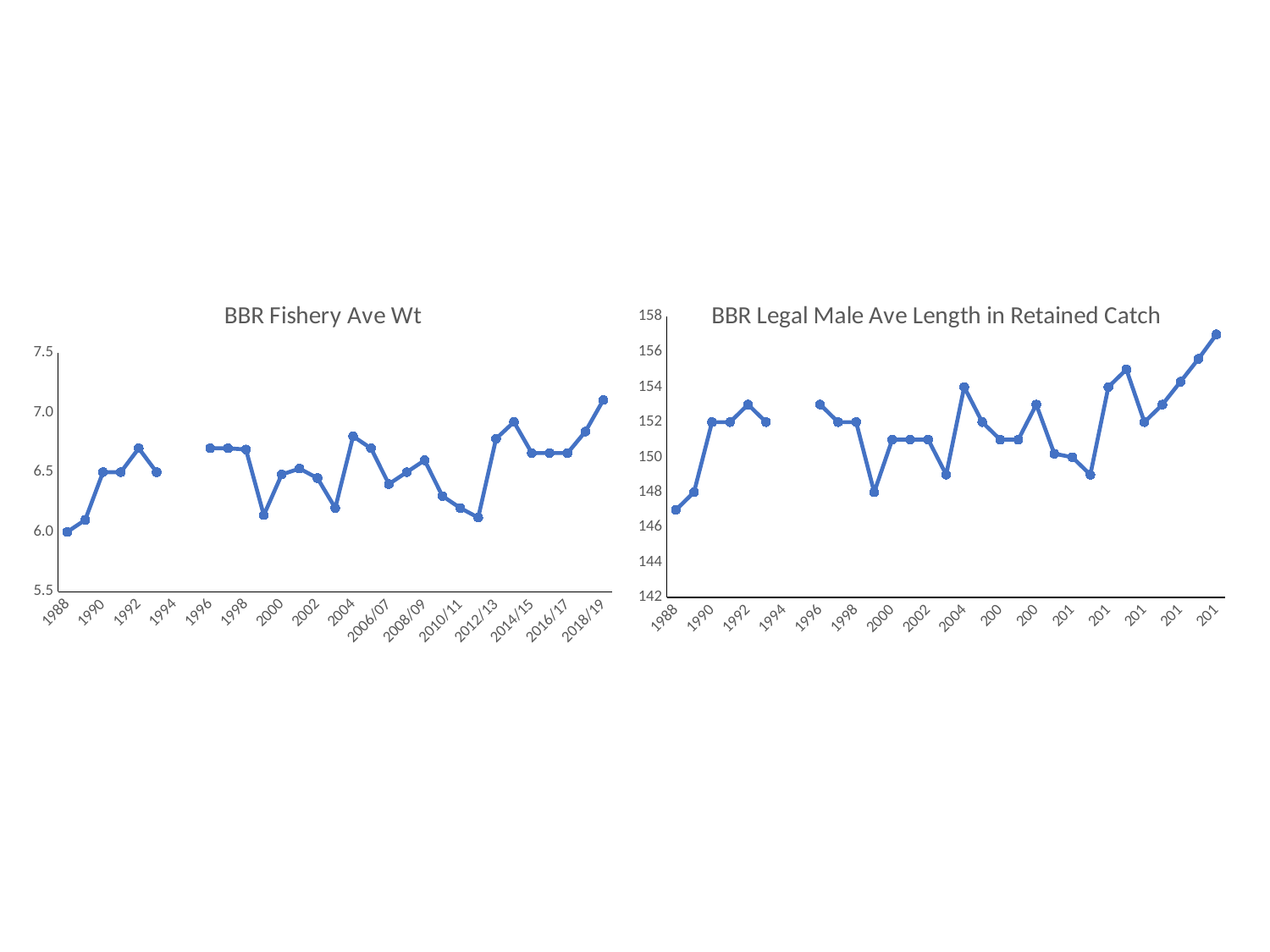
What is the title of the chart on the right? BBR Legal Male Ave Length in Retained Catch In the 'BBR Legal Male Ave Length in Retained Catch' chart, do the values overall rise or fall from the first point to the last point? rise In the 'BBR Legal Male Ave Length in Retained Catch' chart, is the value for the last point on the right greater or less than 156? greater In the 'BBR Fishery Ave Wt' chart, which year has the lowest value? 1988 In the 'BBR Fishery Ave Wt' chart, which is larger, the value for 1988 or the value for 2018/19? 2018/19 In the 'BBR Fishery Ave Wt' chart, is the value for 2018/19 greater or less than 7.0? greater In the 'BBR Legal Male Ave Length in Retained Catch' chart, is the value for 1988 greater or less than 148? less What kind of chart is the 'BBR Fishery Ave Wt' chart on the left? line chart In the 'BBR Fishery Ave Wt' chart, which year has the highest value? 2018/19 In the 'BBR Legal Male Ave Length in Retained Catch' chart, which year has the lowest value? 1988